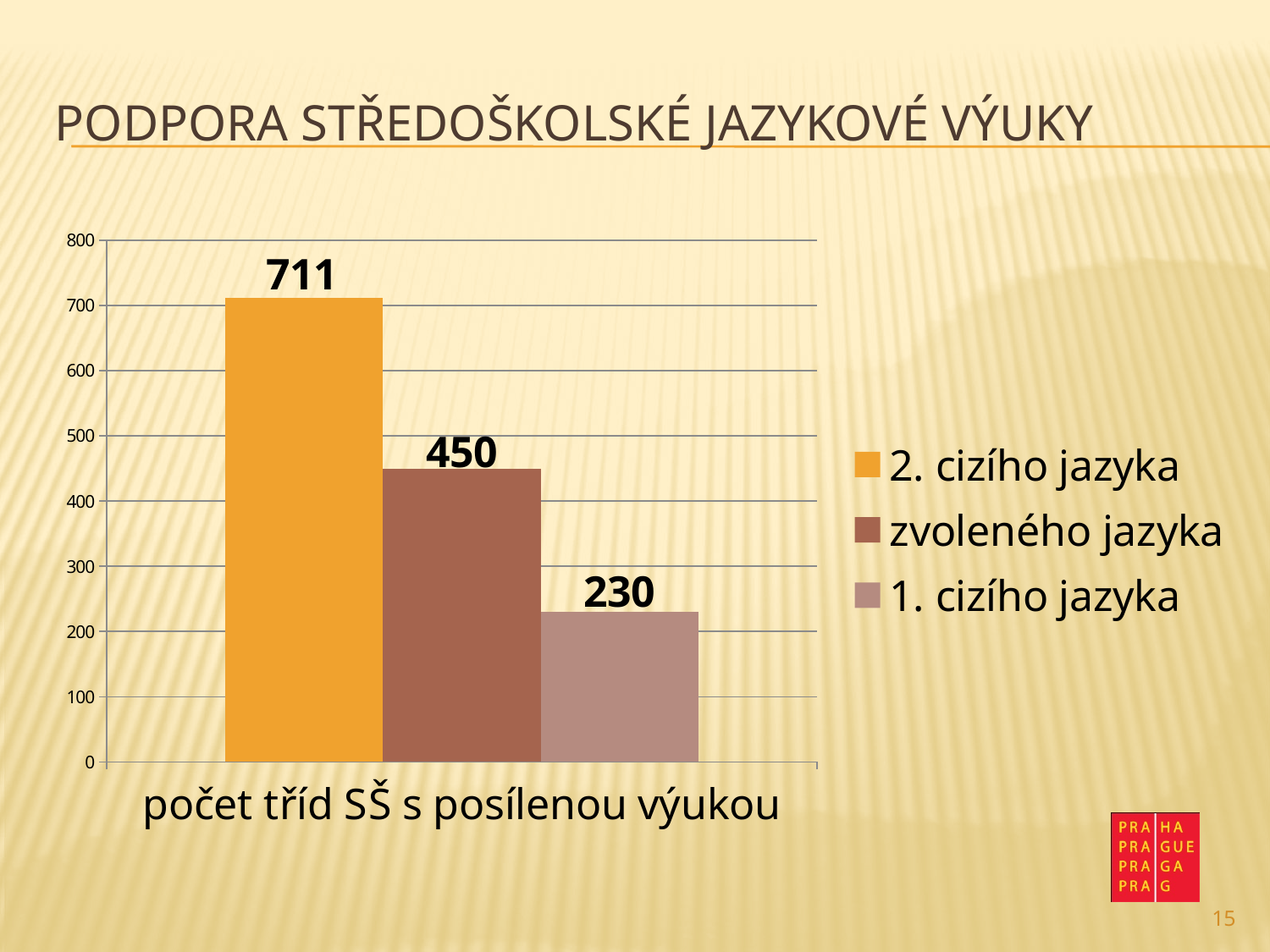
Which is larger, the value for "zvoleného jazyka" or the value for "1. cizího jazyka"? zvoleného jazyka What is the difference between the values for "zvoleného jazyka" and "1. cizího jazyka"? 220 Is the value for "2. cizího jazyka" greater or less than 700? greater How many series does the legend list? 3 Which series has the lowest value? 1. cizího jazyka What is the value for "1. cizího jazyka"? 230 What is the value for "zvoleného jazyka"? 450 What is the category label shown below the bars? počet tříd SŠ s posílenou výukou Which series has the highest value? 2. cizího jazyka What is the difference between the values for "2. cizího jazyka" and "zvoleného jazyka"? 261 What is the value for "2. cizího jazyka"? 711 What kind of chart is shown on the slide? bar chart